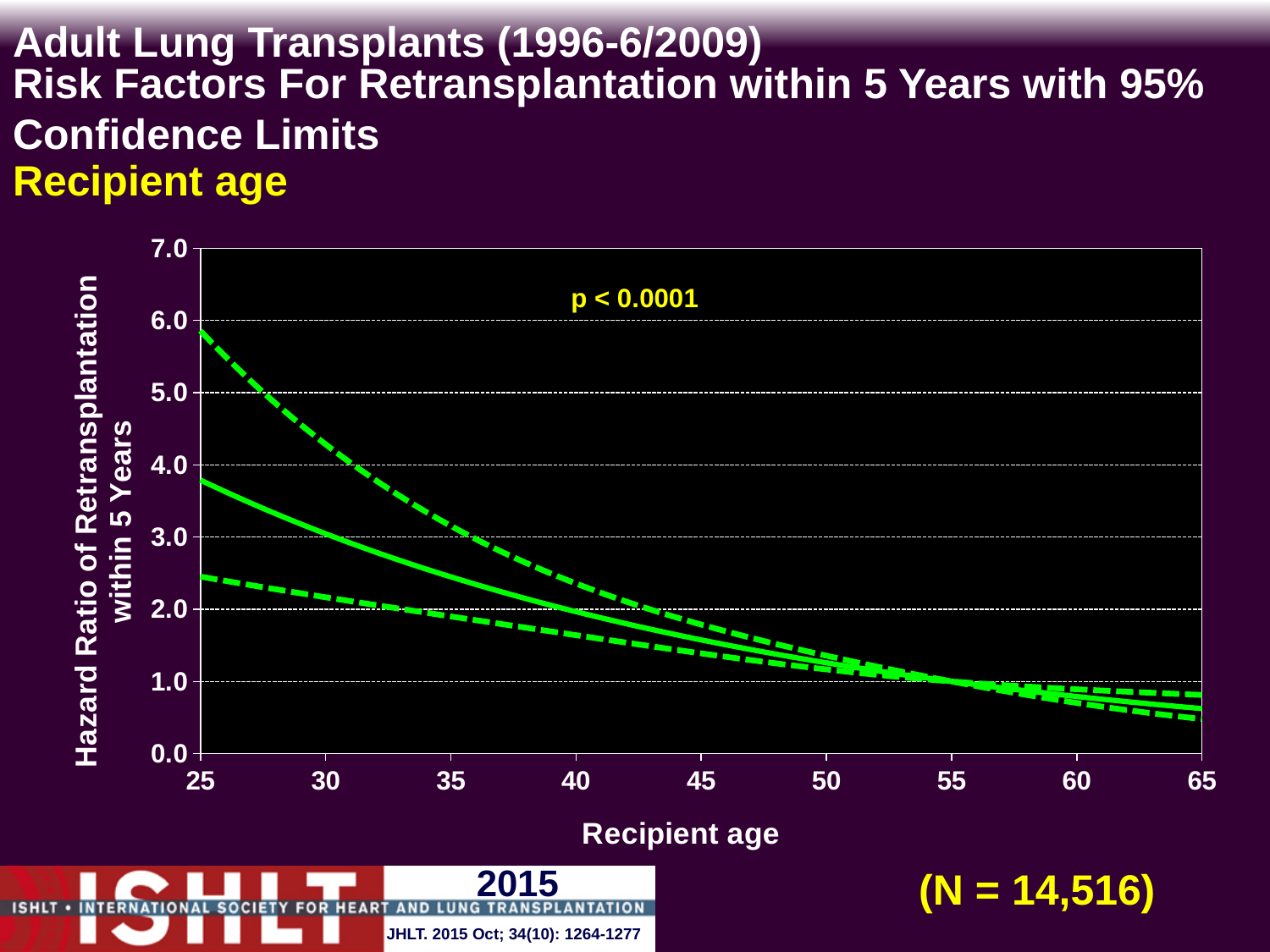
What p-value is printed on the chart? p < 0.0001 Is the upper dashed confidence limit at recipient age 25 greater or less than 5.0? greater Is the hazard ratio on the solid line at recipient age 65 greater or less than 1.0? less How many lines are plotted on the chart? 3 At recipient age 25, which is larger: the upper dashed confidence limit or the solid hazard ratio line? the upper dashed confidence limit Is the lower dashed confidence limit at recipient age 25 greater or less than 2.0? greater As recipient age increases from 25 to 65, does the hazard ratio of retransplantation within 5 years rise or fall? fall What kind of chart is shown on the slide? line chart What is the label of the x axis? Recipient age